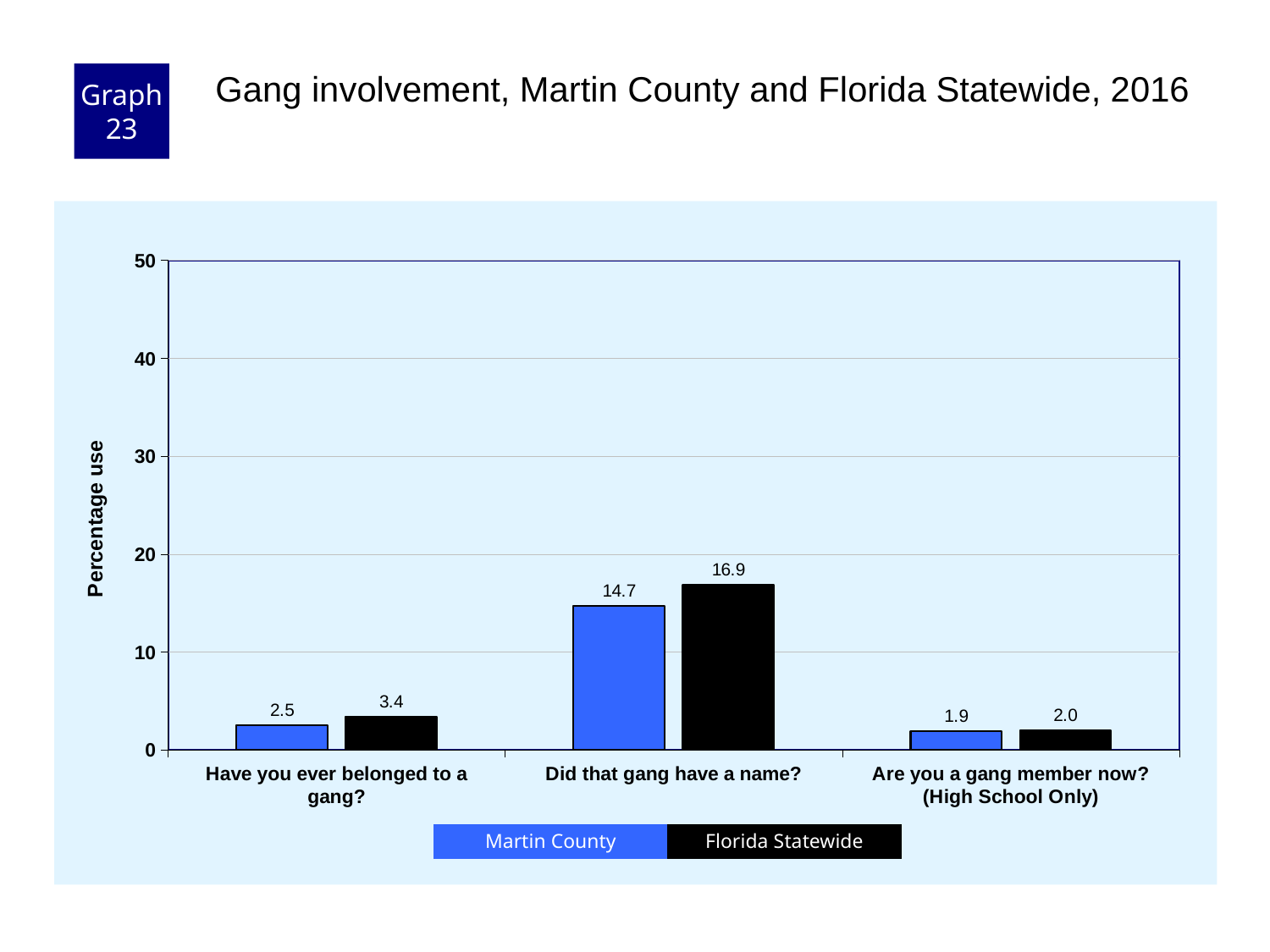
Which question has the highest Florida Statewide value? Did that gang have a name? How many question categories are shown on the x axis? 3 For "Have you ever belonged to a gang?", which is larger: Martin County or Florida Statewide? Florida Statewide Which question has the lowest Martin County value? Are you a gang member now? (High School Only) What kind of chart is shown on the slide? bar chart What is the Martin County value for "Did that gang have a name?"? 14.7 What is the Martin County value for "Are you a gang member now? (High School Only)"? 1.9 What is the Florida Statewide value for "Have you ever belonged to a gang?"? 3.4 What is the label of the y axis? Percentage use How many series does the legend list? 2 Is the Florida Statewide value for "Did that gang have a name?" greater or less than 20? less What is the difference between the Florida Statewide and Martin County values for "Did that gang have a name?"? 2.2